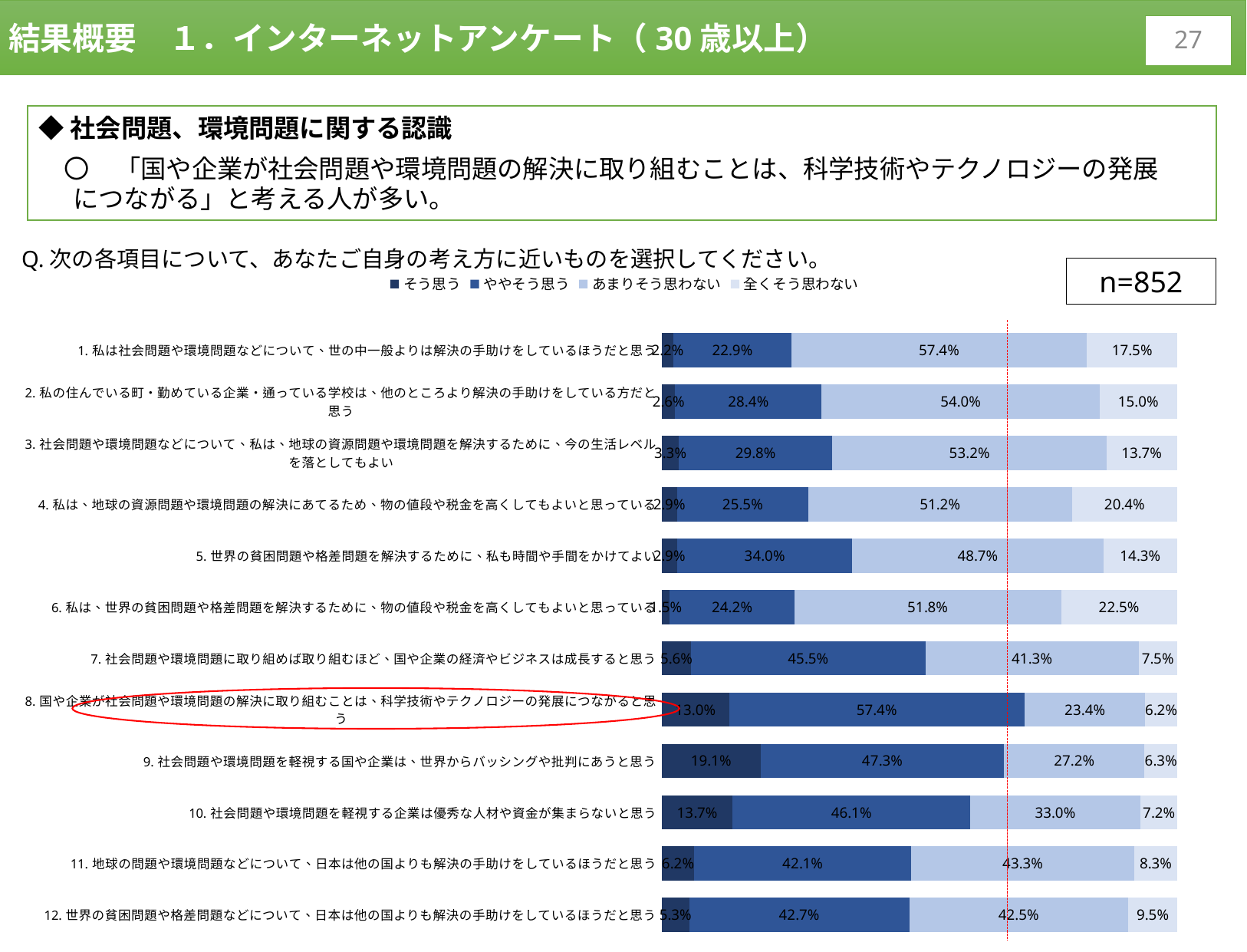
What is the difference in ややそう思う between item 8 (57.4%) and item 9 (47.3%)? 10.1 percentage points What is the value of そう思う for item 9 (社会問題や環境問題を軽視する国や企業は、世界からバッシングや批判にあうと思う)? 19.1% What is the value of あまりそう思わない for item 10 (社会問題や環境問題を軽視する企業は優秀な人材や資金が集まらないと思う)? 33.0% How many items (categories) are plotted in the chart? 12 What sample size (n) is shown next to the chart? n=852 What kind of chart is shown on the slide? Stacked bar chart Which item has the highest value for ややそう思う? Item 8 (57.4%) Which item has the highest value for そう思う? Item 9 (19.1%) Which item has the highest value for 全くそう思わない? Item 6 (22.5%) What is the value of ややそう思う for item 8 (国や企業が社会問題や環境問題の解決に取り組むことは、科学技術やテクノロジーの発展につながると思う)? 57.4% How many series does the legend list? 4 Which has the larger value for 全くそう思わない: item 4 or item 6? Item 6 (22.5%)